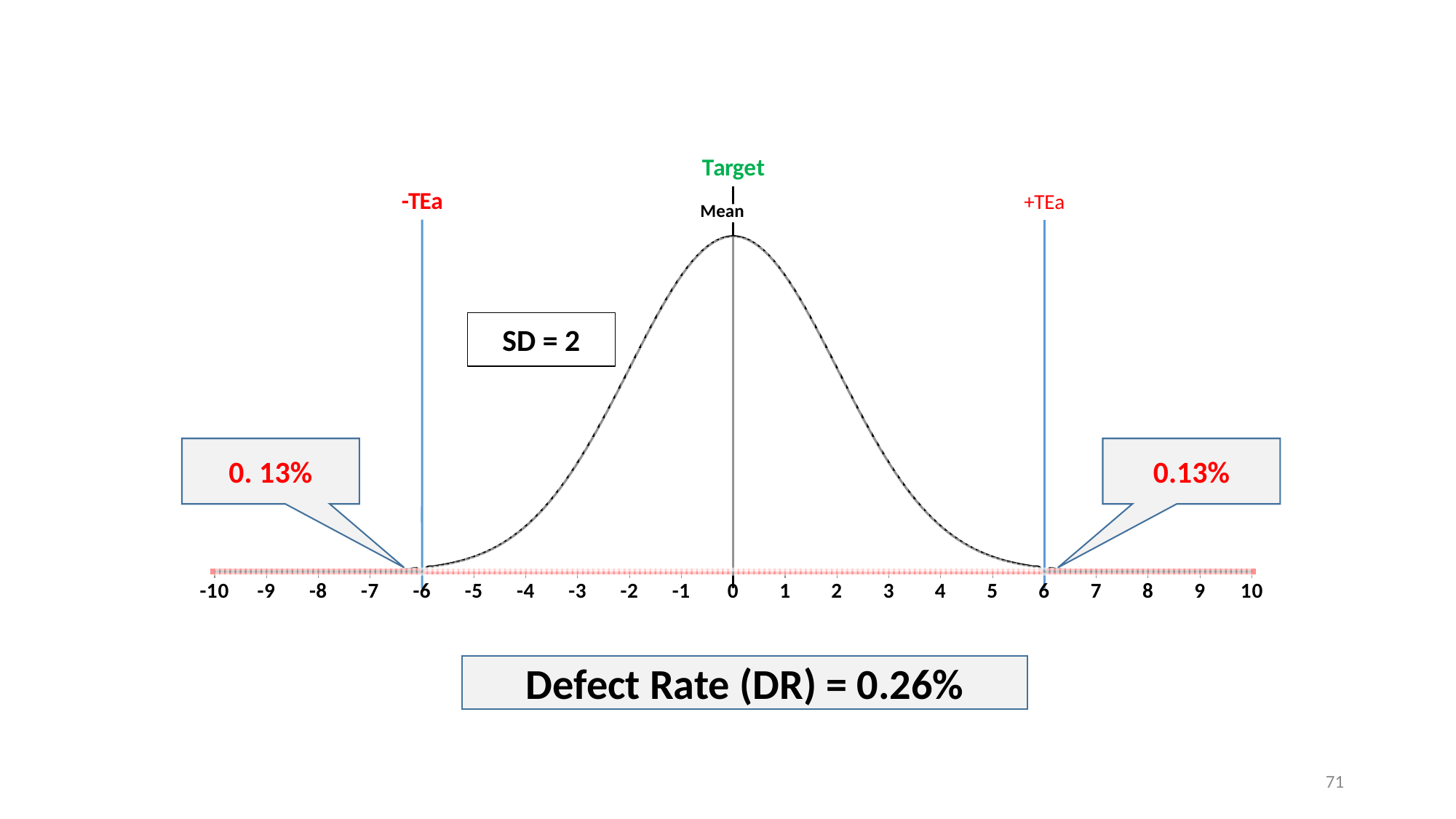
What kind of chart is shown on the slide? line chart What is the value of SD shown in the box on the chart? 2 What percentage is shown in the callout beyond the +TEa line? 0.13% At which x-axis value is the -TEa vertical line placed? -6 What is the green label shown above the peak of the curve? Target Does the curve rise or fall as x goes from -6 to 0? rise Does the curve rise or fall as x goes from 0 to 6? fall How many tick labels are shown on the x axis? 21 At which x-axis value is the +TEa vertical line placed? 6 What colour are the -TEa and +TEa vertical lines? blue At which x-axis value does the curve reach its peak? 0 What is the Defect Rate (DR) stated below the chart? 0.26%